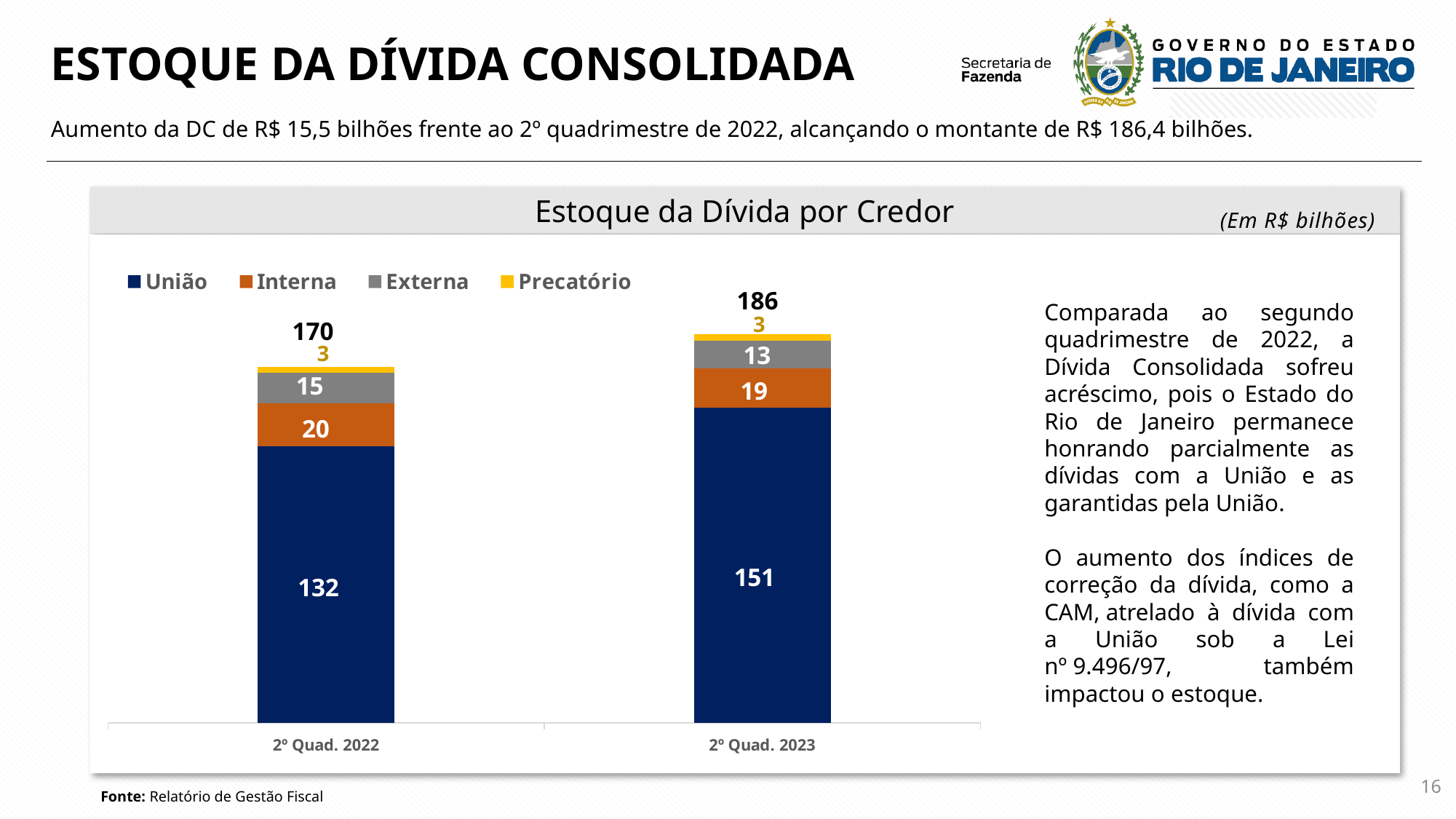
How many periods are shown on the x axis? 2 What is the value of the União segment for 2º Quad. 2023? 151 How many series does the legend list? 4 What is the difference between the União values for 2º Quad. 2023 and 2º Quad. 2022? 19 What is the total of the stacked bar for 2º Quad. 2023? 186 What is the value of the Externa segment for 2º Quad. 2023? 13 What is the value of the Interna segment for 2º Quad. 2022? 20 What is the total of the stacked bar for 2º Quad. 2022? 170 What kind of chart is shown? Stacked bar chart Which period has the higher total debt stock? 2º Quad. 2023 Is the Interna value larger in 2º Quad. 2022 or 2º Quad. 2023? 2º Quad. 2022 What is the title of the chart? Estoque da Dívida por Credor